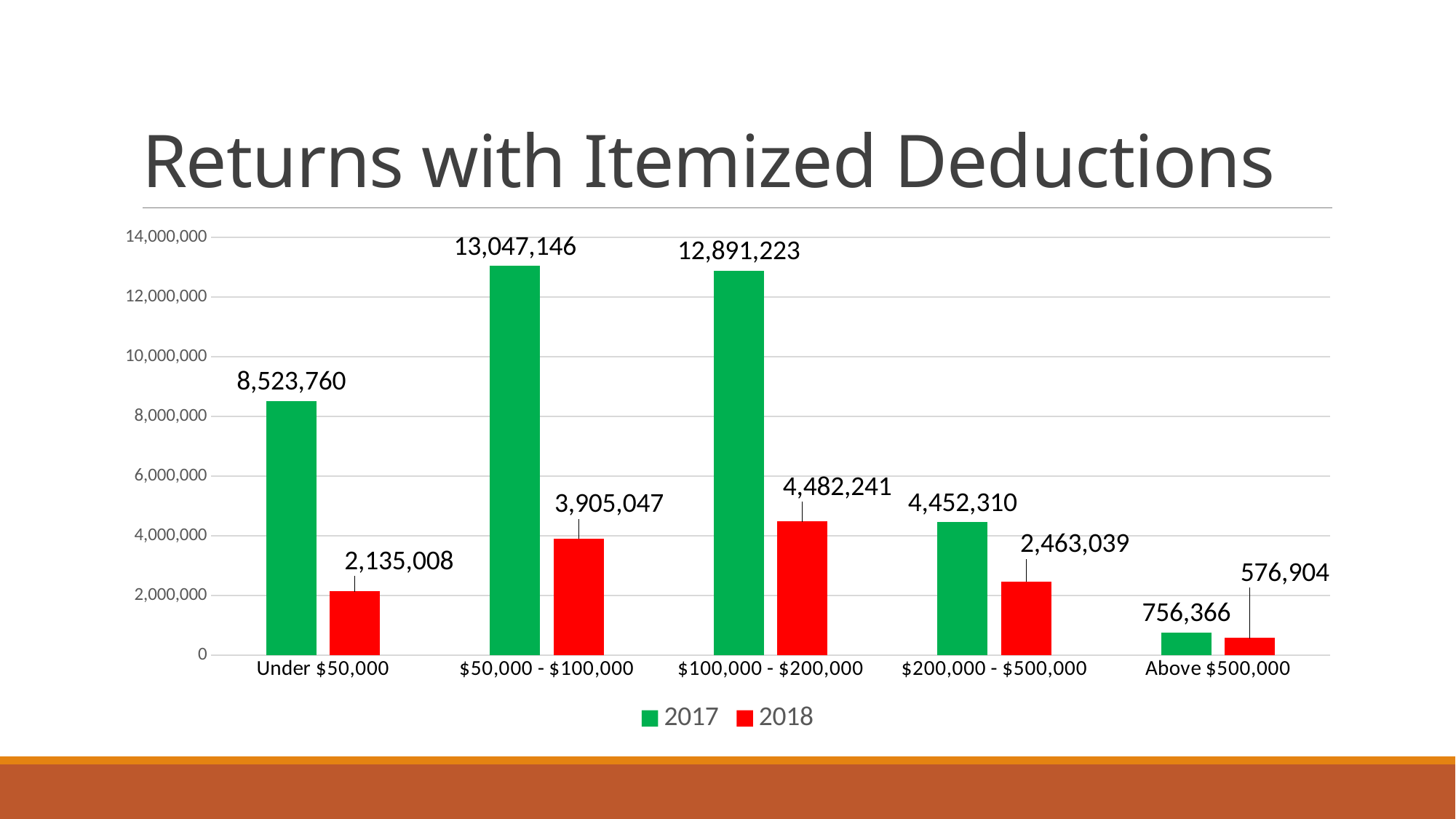
What type of chart is shown on the slide? Bar chart What is the 2017 value for the $100,000 - $200,000 category? 12,891,223 Which is larger, the 2018 value for $50,000 - $100,000 or the 2018 value for $100,000 - $200,000? $100,000 - $200,000 What is the 2018 value for the Under $50,000 category? 2,135,008 What is the difference between the 2017 and 2018 values for the Above $500,000 category? 179,462 What is the 2018 value for the Above $500,000 category? 576,904 Which category has the highest 2017 value? $50,000 - $100,000 How many series does the legend list? 2 How many income categories are shown on the x axis? 5 Which category has the lowest 2018 value? Above $500,000 Which category has the highest 2018 value? $100,000 - $200,000 What is the difference between the 2017 and 2018 values for the Under $50,000 category? 6,388,752